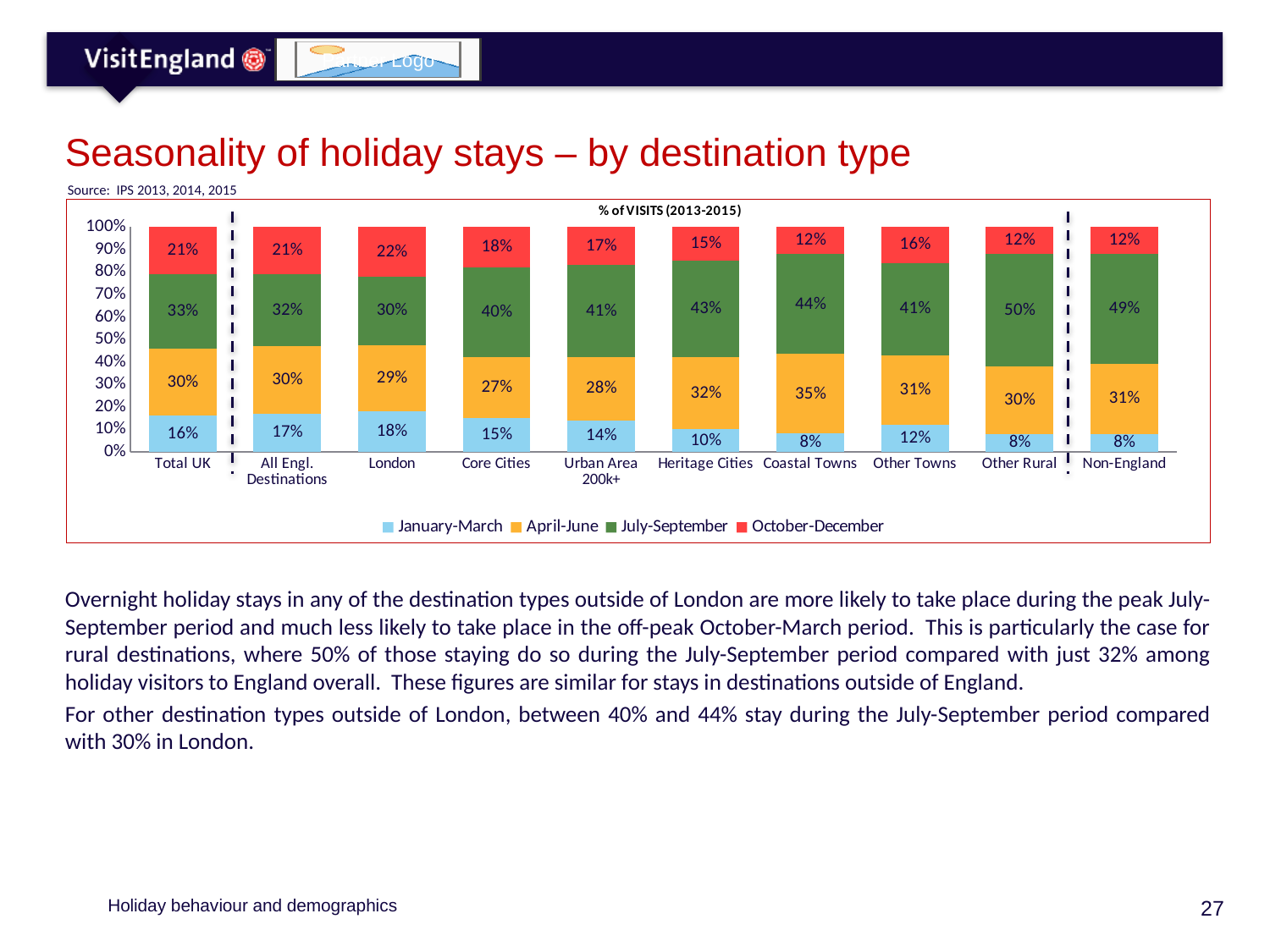
Which destination type has the highest April-June share of visits? Coastal Towns What type of chart is used on the slide? Stacked bar chart How many destination types are shown on the x axis of the chart? 10 Which has a larger July-September share of visits, London or Heritage Cities? Heritage Cities What percentage of visits to Other Rural destinations take place in July-September? 50% How many series does the chart legend list? 4 Which destination type has the lowest April-June share of visits? Core Cities Which destination type has the highest July-September share of visits? Other Rural What is the January-March share of visits for London? 18% What percentage of visits to Coastal Towns occur in April-June? 35% What is the October-December share for Total UK? 21% What is the difference between the July-September share for Other Rural and for All Engl. Destinations? 18 percentage points